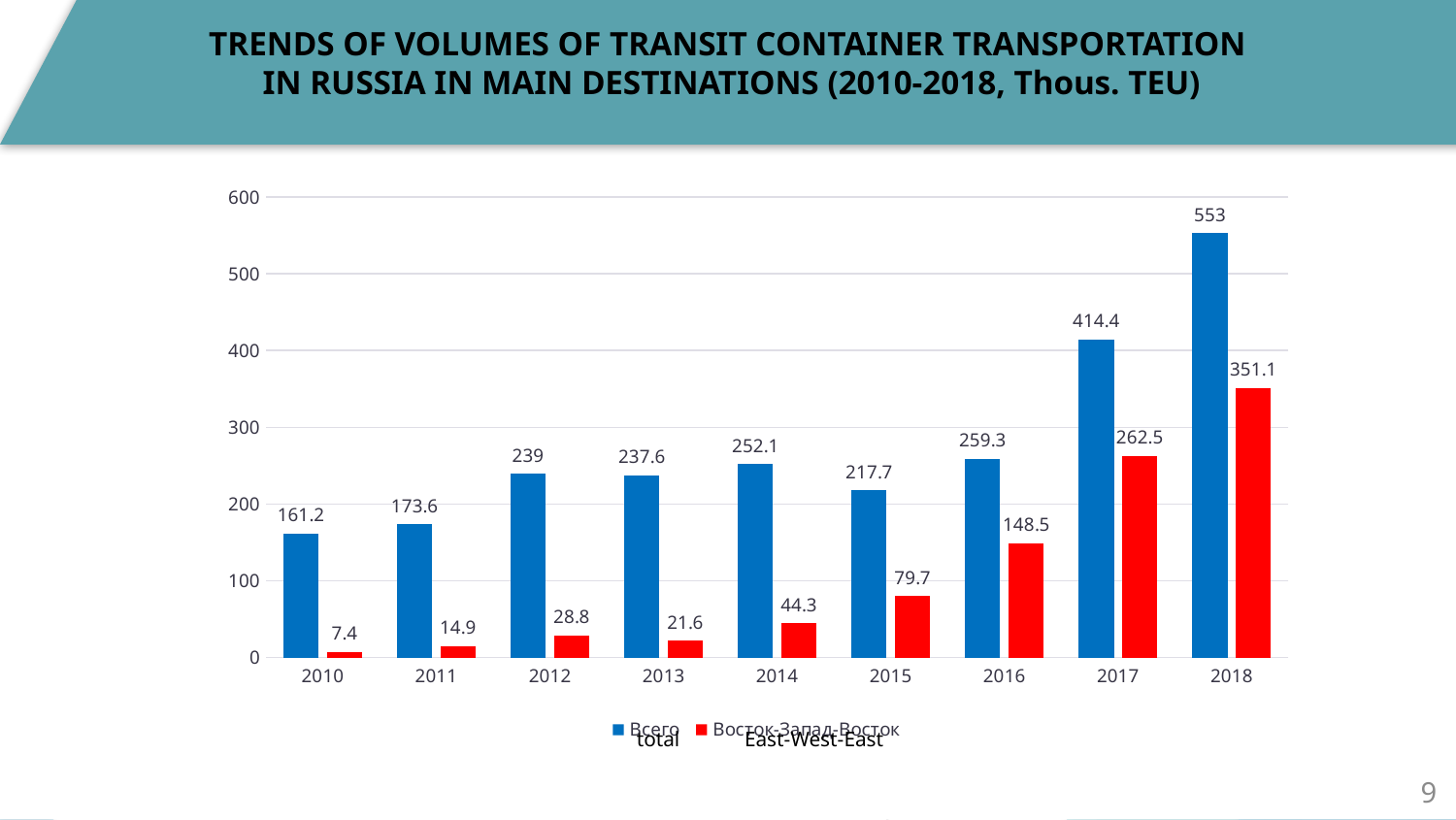
What is the East-West-East volume in 2010? 7.4 How many years are shown on the x axis? 9 What kind of chart is shown on the slide? bar chart What is the total transit container volume in 2017? 414.4 Does the East-West-East volume rise or fall from 2015 to 2018? rise How many series does the legend list? 2 What is the difference between the total volume and the East-West-East volume in 2018? 201.9 Which is larger, the total volume in 2012 or the total volume in 2013? 2012 Is the total volume in 2015 greater or less than 200? greater Which year has the highest total volume? 2018 What is the East-West-East volume in 2016? 148.5 Which year has the lowest East-West-East volume? 2010